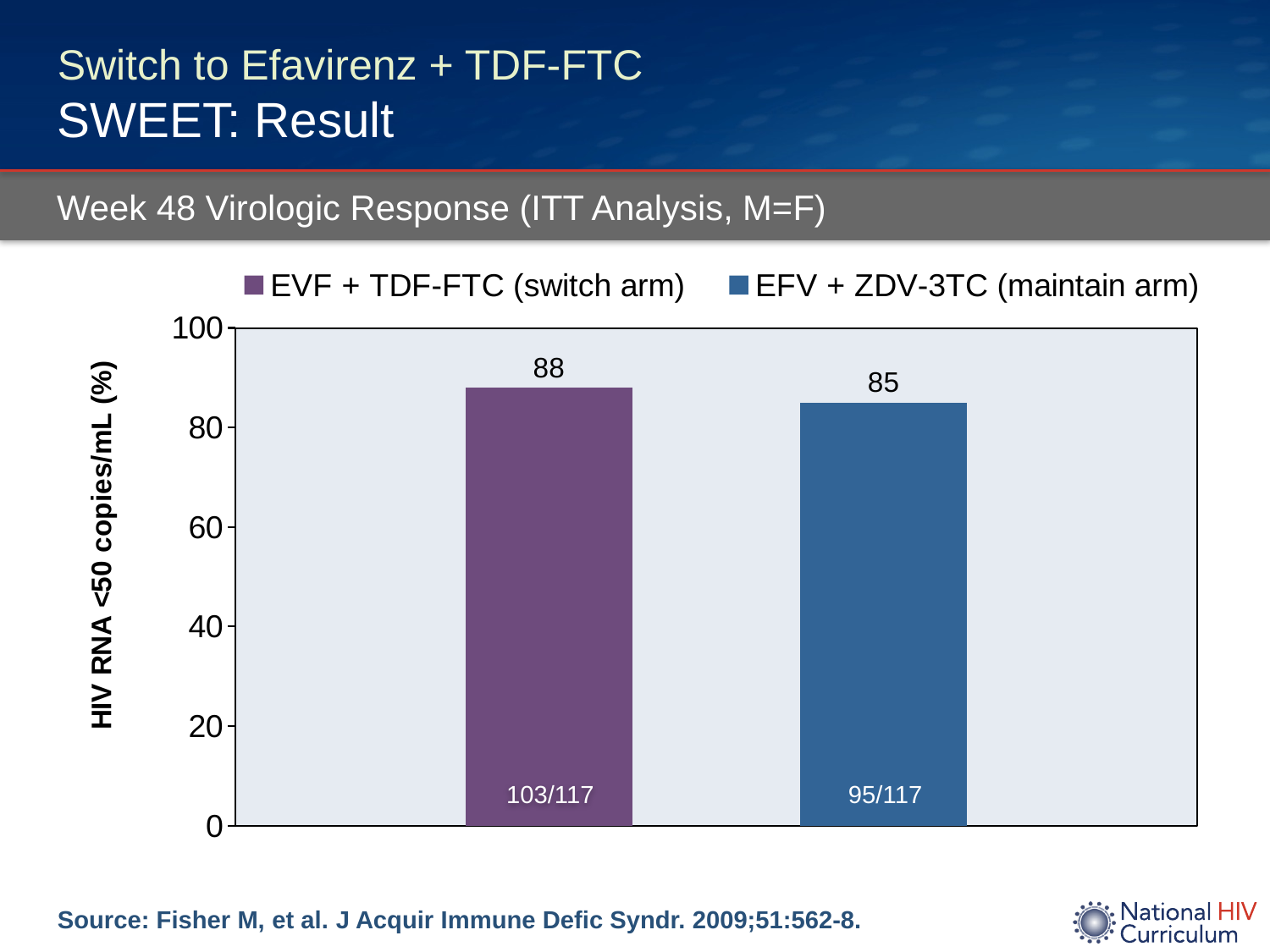
What is the difference between the switch arm and the maintain arm values? 3 How many bars are plotted in the chart? 2 What kind of chart is shown on the slide? bar chart What is the label of the y axis? HIV RNA <50 copies/mL (%) Is the value for EFV + ZDV-3TC (maintain arm) greater or less than 80? greater Is the value for the switch arm larger or smaller than the value for the maintain arm? larger Which arm has the higher percentage with HIV RNA <50 copies/mL? EVF + TDF-FTC (switch arm) What is the value for EFV + ZDV-3TC (maintain arm)? 85 How many series does the legend list? 2 What fraction is printed inside the bar for the switch arm? 103/117 What is the value for EVF + TDF-FTC (switch arm)? 88 Which arm has the lower percentage with HIV RNA <50 copies/mL? EFV + ZDV-3TC (maintain arm)